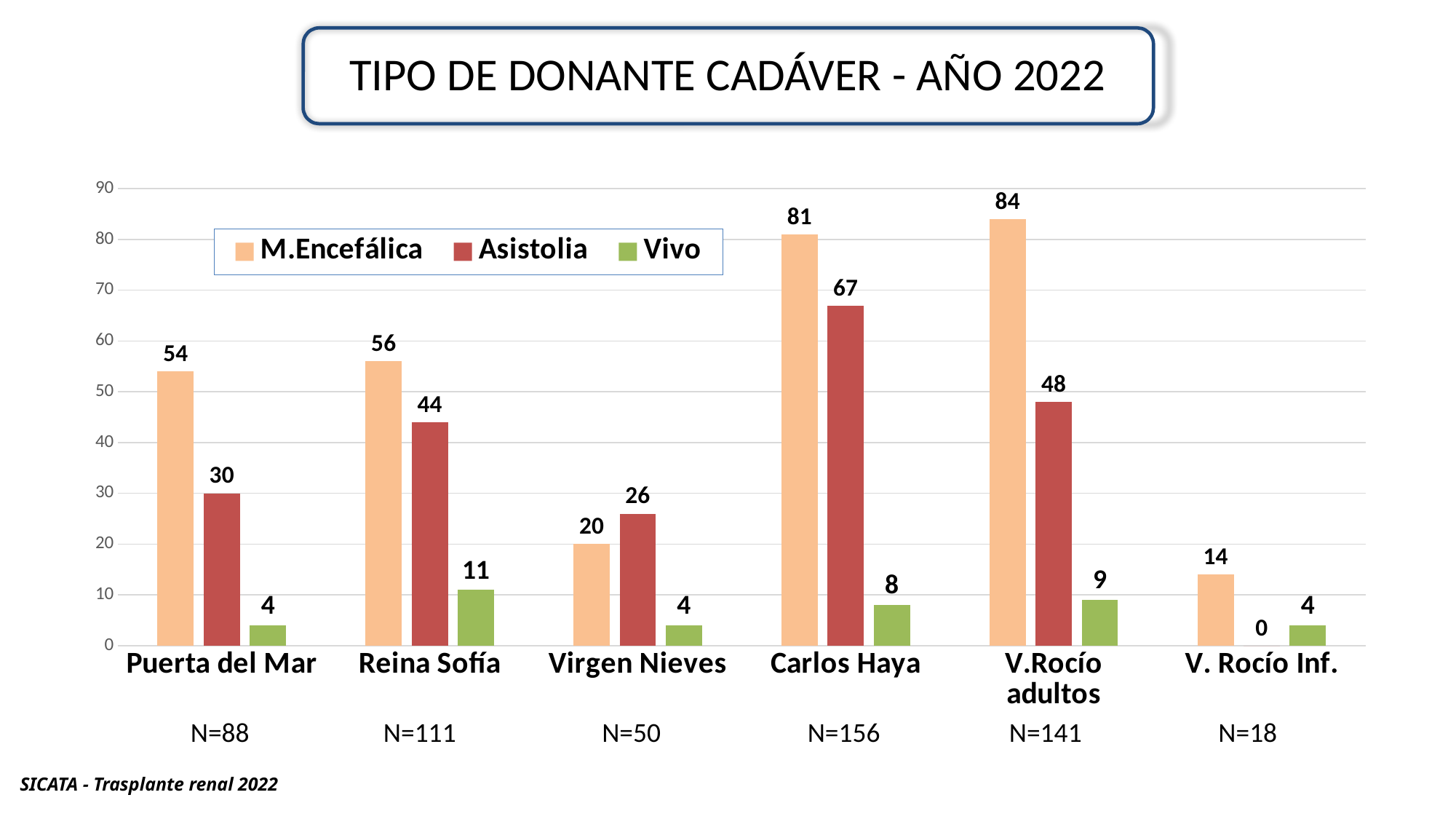
What is the difference between the M.Encefálica and Asistolia values for Puerta del Mar? 24 Is the Asistolia value for Carlos Haya greater or less than 60? greater What is the Vivo value for V.Rocío adultos? 9 How many categories are shown on the x axis? 6 What is the Asistolia value for Reina Sofía? 44 What is the M.Encefálica value for Carlos Haya? 81 Which category has the highest M.Encefálica value? V.Rocío adultos Which category has the lowest Asistolia value? V. Rocío Inf. What is the title of the chart? TIPO DE DONANTE CADÁVER - AÑO 2022 How many series does the legend list? 3 For Virgen Nieves, which is larger: M.Encefálica or Asistolia? Asistolia What kind of chart is shown on the slide? Bar chart